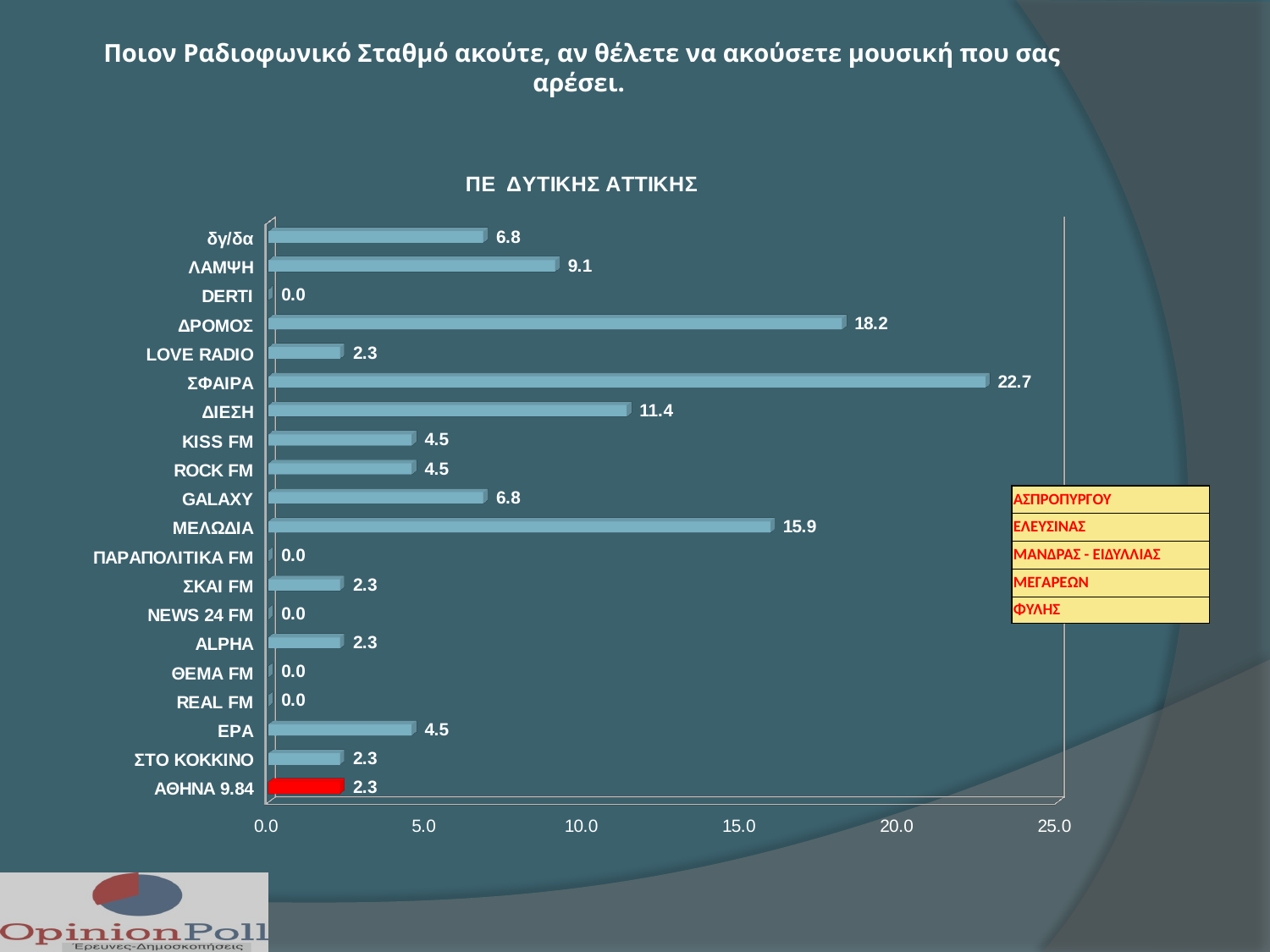
What is the difference between the values for ΣΦΑΙΡΑ and ΔΡΟΜΟΣ? 4.5 What kind of chart is shown on the slide? Bar chart How many radio stations are listed on the chart? 20 What is the value for ΑΘΗΝΑ 9.84? 2.3 What is the value for ΜΕΛΩΔΙΑ? 15.9 Which radio station has the highest value? ΣΦΑΙΡΑ What is the value for ΣΦΑΙΡΑ? 22.7 Which radio station's bar is coloured red? ΑΘΗΝΑ 9.84 How many radio stations have a value of 0.0? 5 Which has a larger value, ΛΑΜΨΗ or GALAXY? ΛΑΜΨΗ What is the difference between the values for ΜΕΛΩΔΙΑ and ΔΙΕΣΗ? 4.5 What is the value for ΔΙΕΣΗ? 11.4